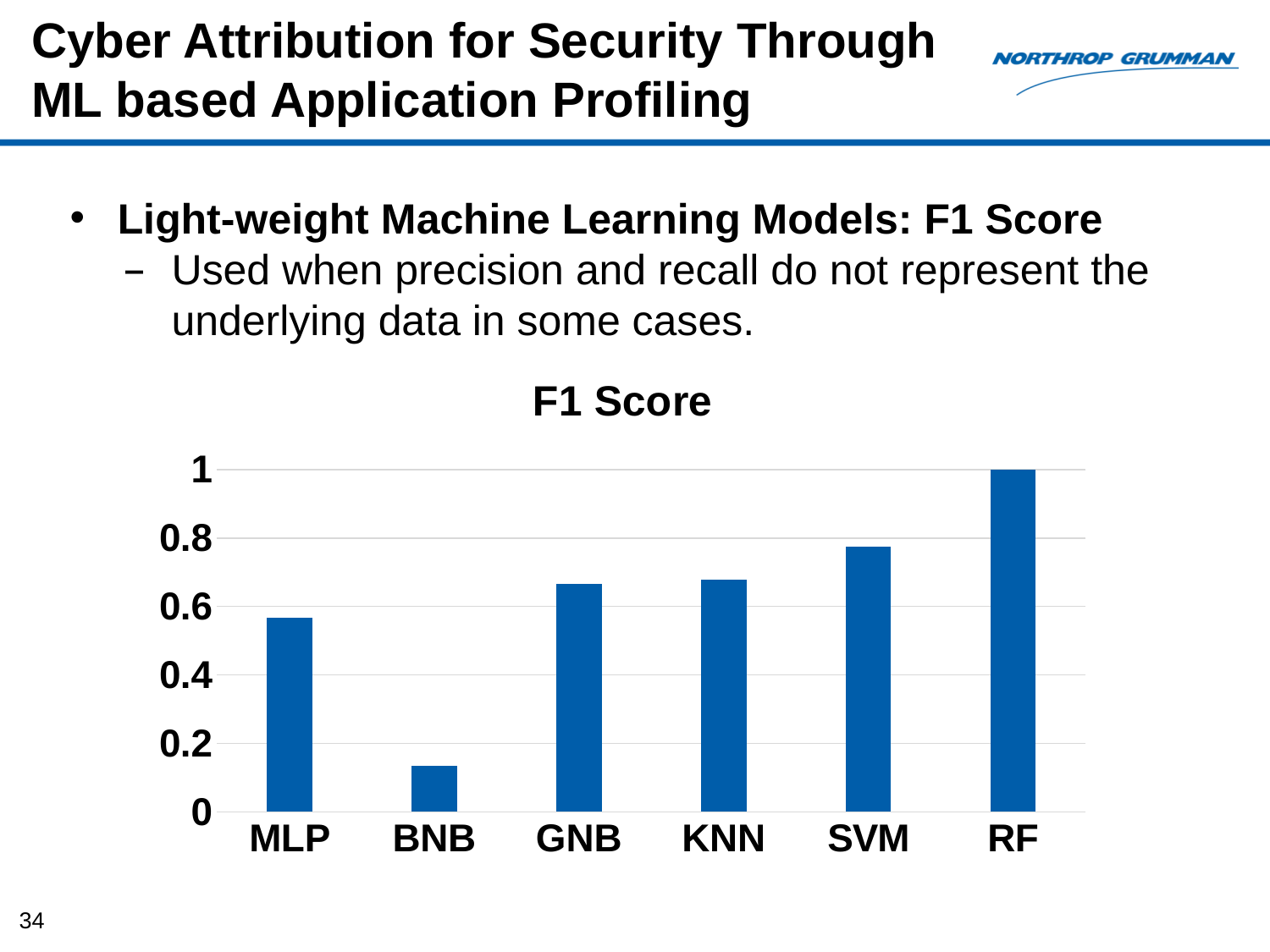
Is the F1 Score for MLP greater or less than 0.6? less Which has a higher F1 Score, SVM or MLP? SVM What is the F1 Score for RF? 1 Is the F1 Score for SVM greater or less than 0.8? less Which has a higher F1 Score, BNB or KNN? KNN How many models (categories) are shown on the x axis of the F1 Score chart? 6 Is the F1 Score for BNB greater or less than 0.2? less Which model has the lowest F1 Score? BNB Which model has the highest F1 Score? RF What kind of chart is shown on the slide? bar chart What is the title of the chart? F1 Score